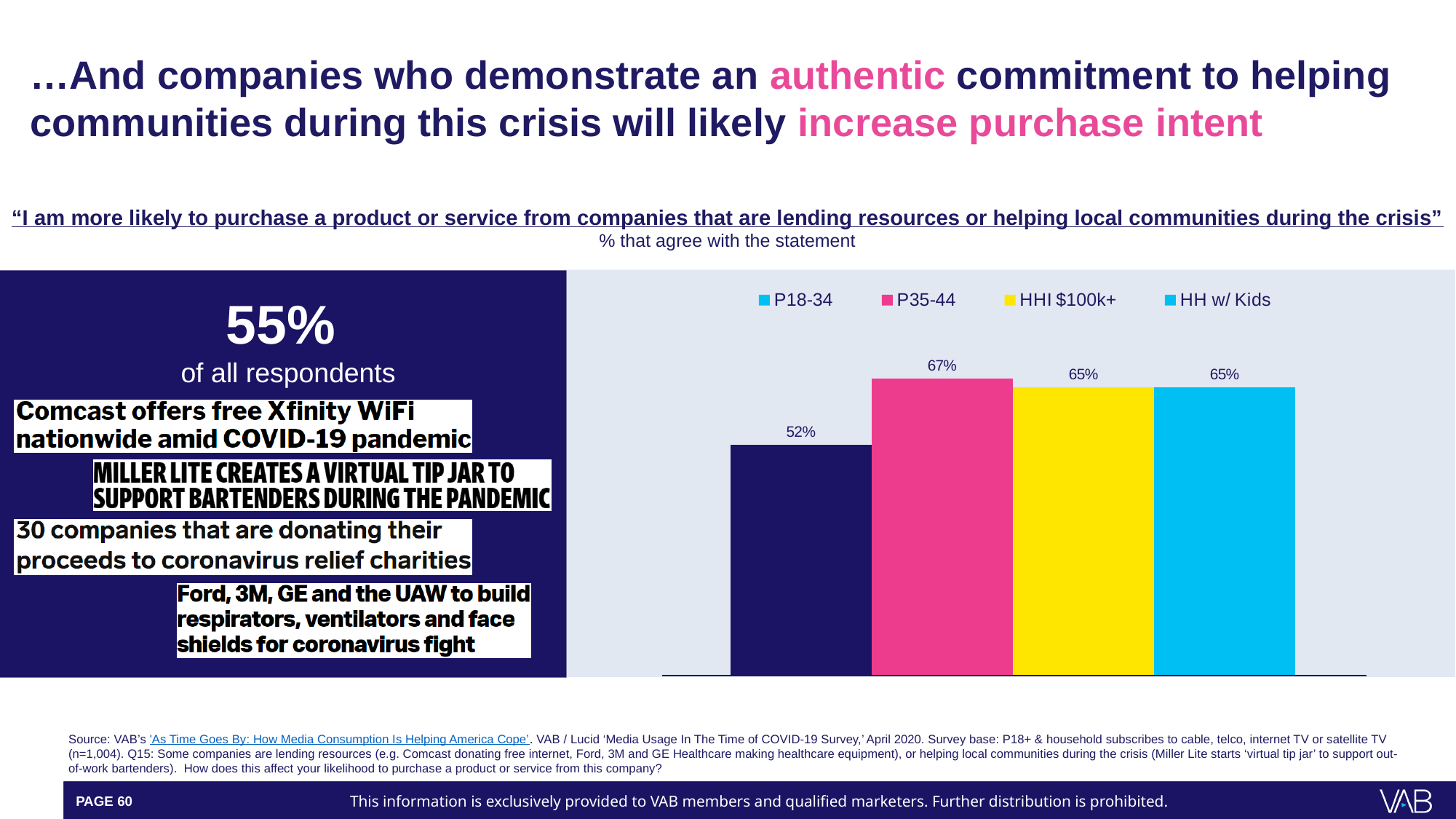
What is the difference in percentage points between P35-44 and HHI $100k+? 2 How many series does the chart legend list? 4 What value is shown for HH w/ Kids? 65% What value is shown for HHI $100k+? 65% Which is larger, the value for P35-44 or the value for HH w/ Kids? P35-44 Which group has the highest percentage agreeing with the statement? P35-44 What percentage of P35-44 respondents agree with the statement? 67% What kind of chart is shown on the slide? Bar chart What is the difference in percentage points between P35-44 and P18-34? 15 Which group has the lowest percentage agreeing with the statement? P18-34 What percentage of P18-34 respondents agree with the statement? 52% What percentage of all respondents agree with the statement, according to the callout on the left? 55%